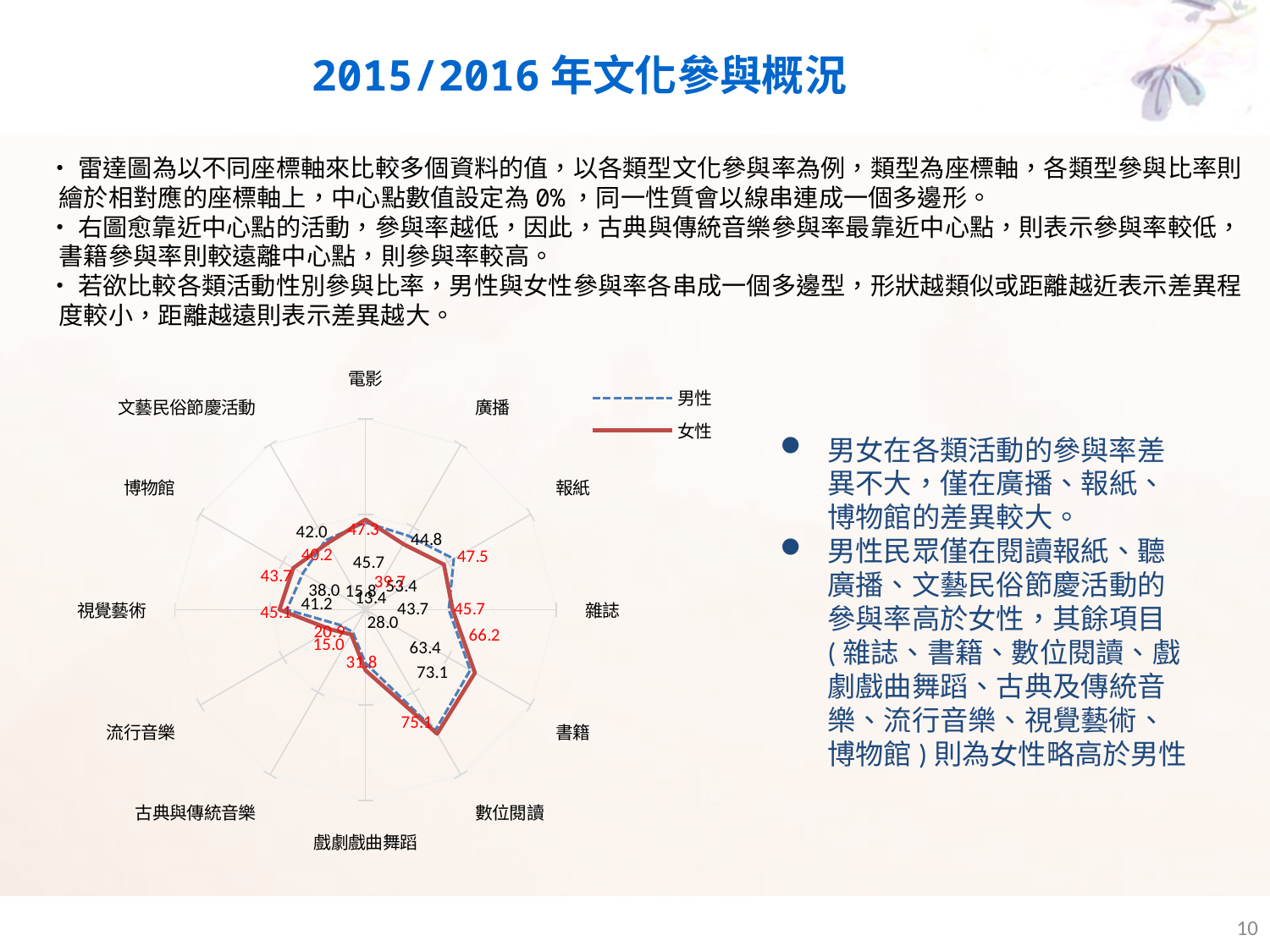
What kind of chart is shown on the slide? radar chart Which has a higher participation rate in the radar chart, 雜誌 or 流行音樂? 雜誌 Which series in the radar chart is drawn with a dashed line? 男性 Which activity category lies closest to the centre of the radar chart, i.e. has the lowest participation rate? 古典與傳統音樂 Which activity category has the highest participation rate in the radar chart? 數位閱讀 What is the largest data label printed on the radar chart? 75.1 What is the 女性 participation rate for 電影 shown on the radar chart? 47.3 Which has a higher participation rate in the radar chart, 書籍 or 古典與傳統音樂? 書籍 What are the two series named in the legend of the radar chart? 男性 and 女性 How many series does the legend of the radar chart list? 2 How many activity categories (axes) does the radar chart have? 12 What is the 女性 participation rate for 書籍 shown on the radar chart? 66.2